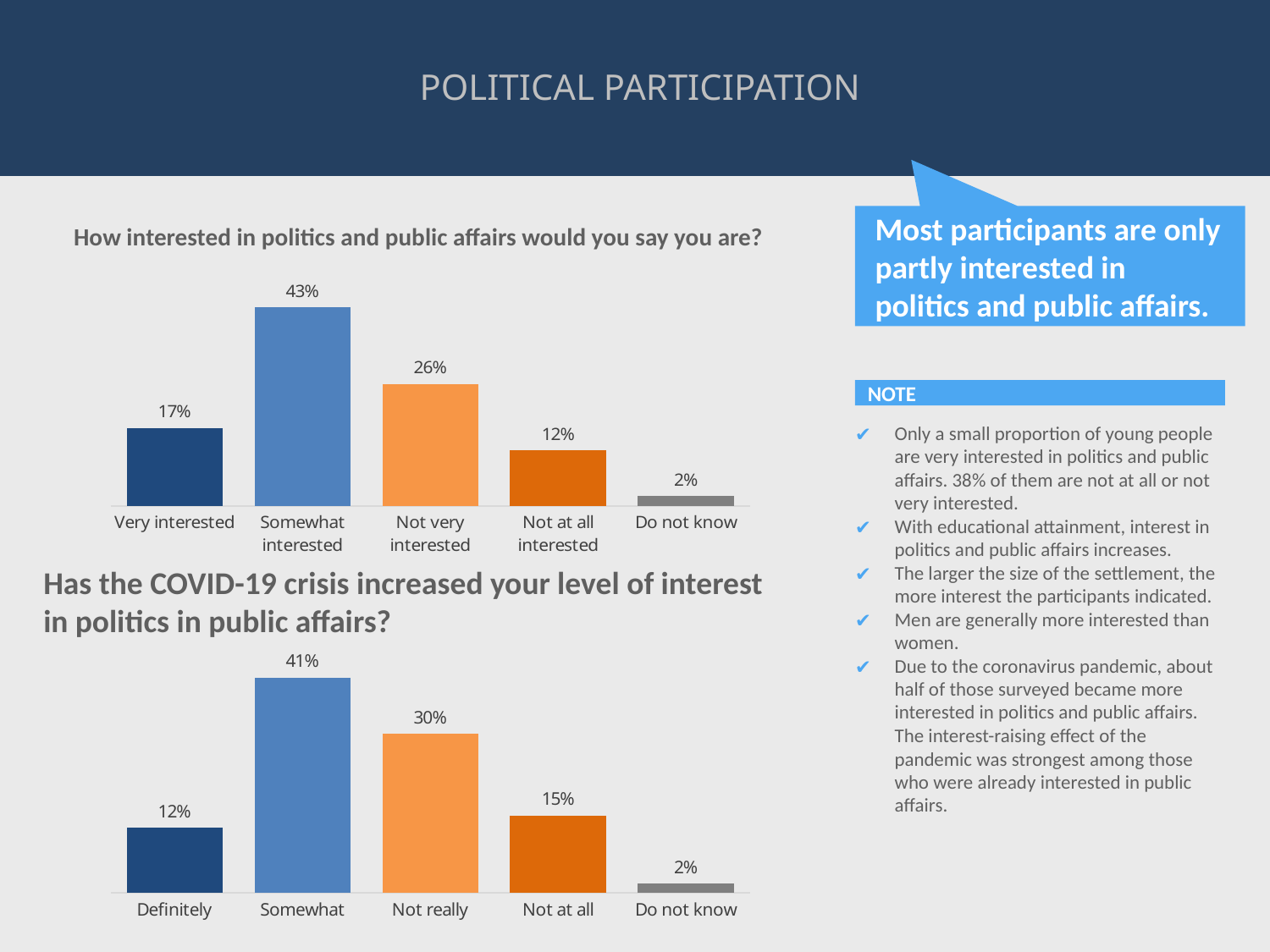
In the chart 'How interested in politics and public affairs would you say you are?', what is the difference between 'Somewhat interested' and 'Very interested'? 26% In the chart 'How interested in politics and public affairs would you say you are?', what colour is the 'Not very interested' bar? Light orange What type of chart is the bottom chart on the slide? Bar chart In the chart 'How interested in politics and public affairs would you say you are?', which category has the lowest value? Do not know In the chart 'Has the COVID-19 crisis increased your level of interest in politics in public affairs?', which is larger: 'Not really' or 'Not at all'? Not really In the chart 'How interested in politics and public affairs would you say you are?', what is the value for 'Not at all interested'? 12% In the chart 'Has the COVID-19 crisis increased your level of interest in politics in public affairs?', what is the value for 'Definitely'? 12% In the chart 'How interested in politics and public affairs would you say you are?', what is the value for 'Somewhat interested'? 43% In the chart 'Has the COVID-19 crisis increased your level of interest in politics in public affairs?', which category has the highest value? Somewhat In the chart 'Has the COVID-19 crisis increased your level of interest in politics in public affairs?', what is the difference between 'Somewhat' and 'Not at all'? 26% In the chart 'How interested in politics and public affairs would you say you are?', how many categories are shown? 5 In the chart 'Has the COVID-19 crisis increased your level of interest in politics in public affairs?', what is the value for 'Not really'? 30%